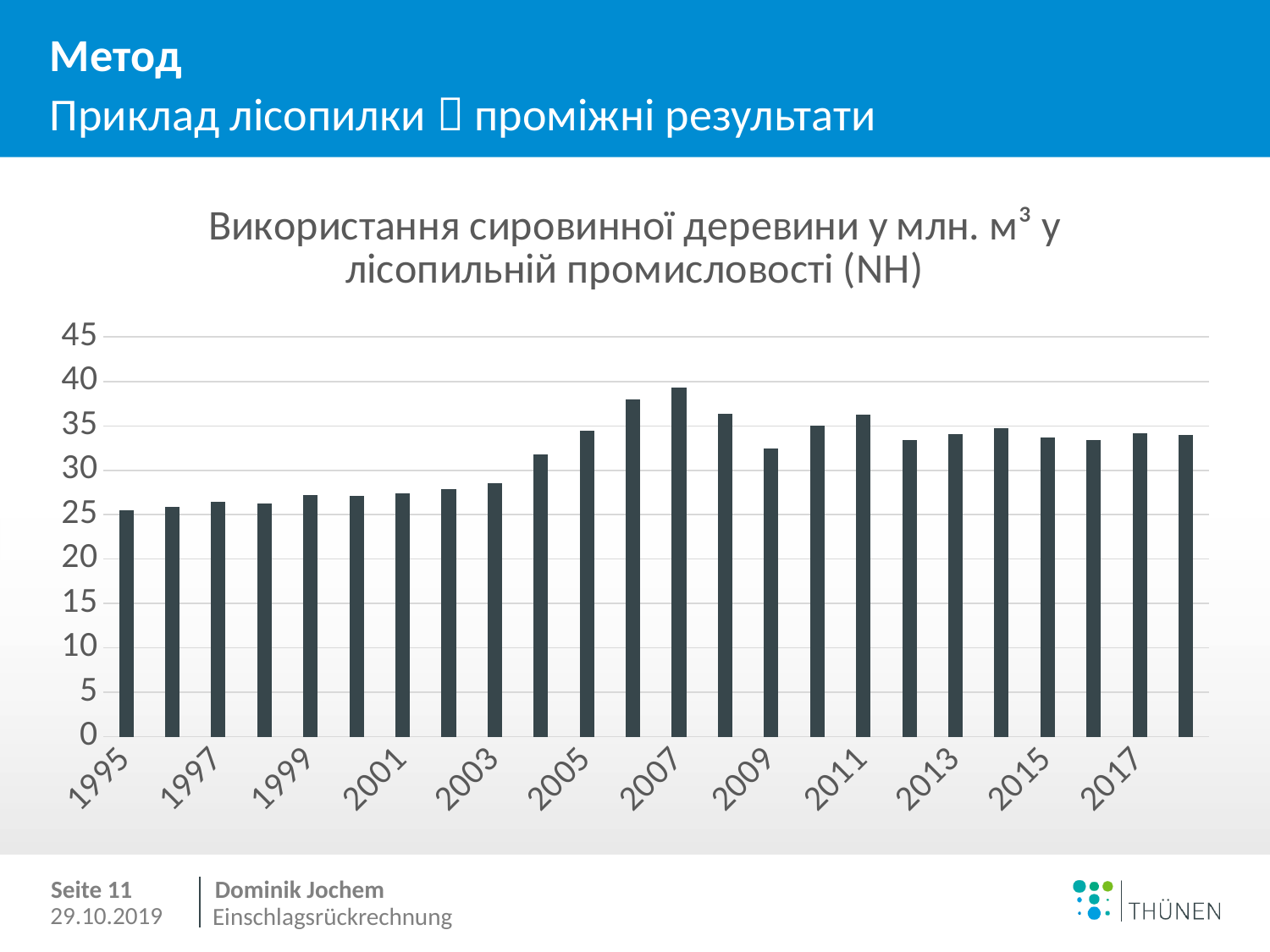
Do the values rise or fall from 1995 to 2007? rise Which is larger, the value for 1995 or the value for 2017? 2017 Is the value for 2007 greater or less than 35? greater Which is larger, the value for 2007 or the value for 2009? 2007 What is the title of the chart? Використання сировинної деревини у млн. м³ у лісопильній промисловості (NH) Is the value for 2006 greater or less than 35? greater Is the value for 2003 greater or less than 30? less Which year has the highest value in the chart? 2007 What kind of chart is shown on the slide? bar chart How many bars (years) are plotted in the chart? 24